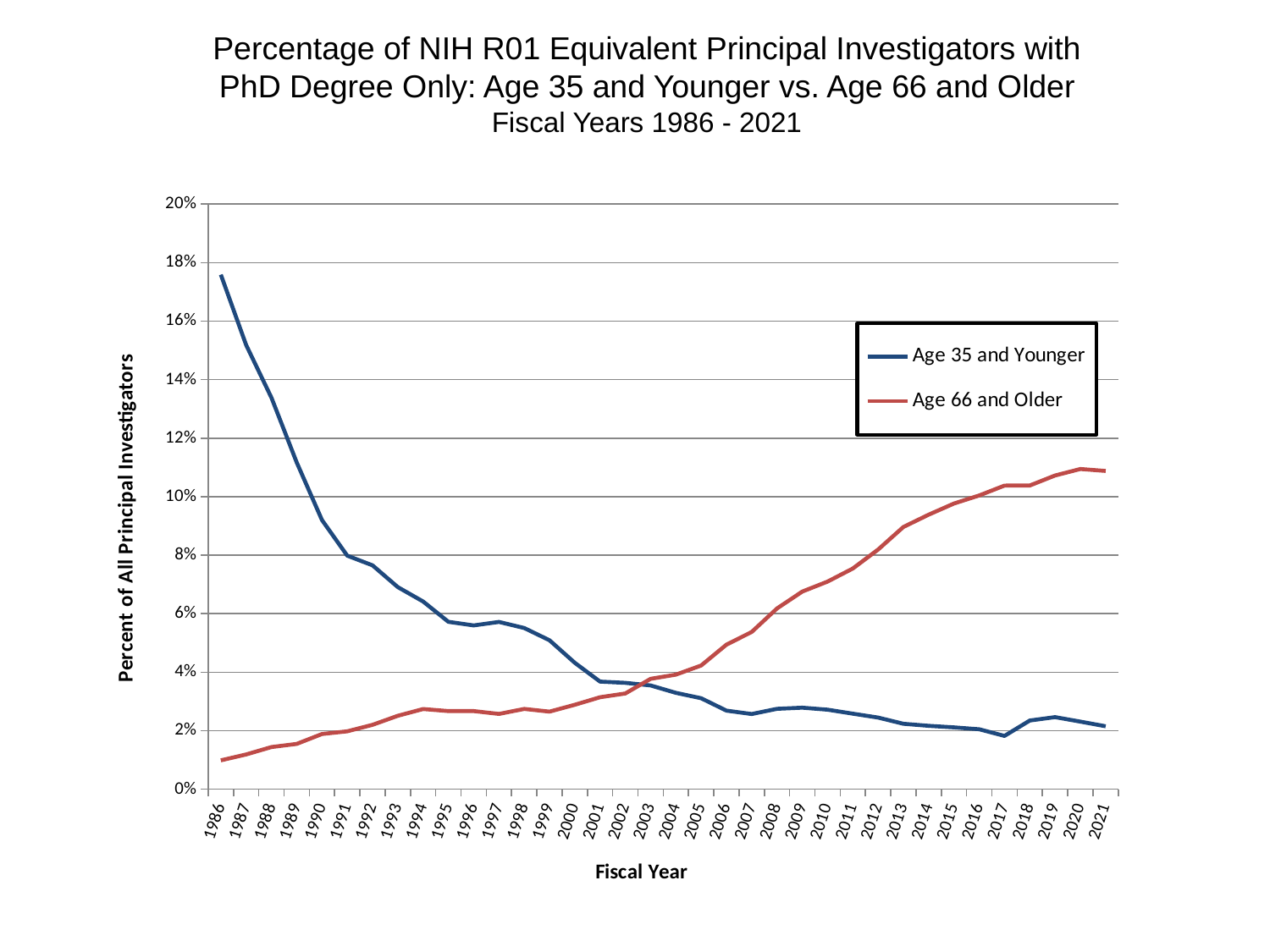
Is the value for Age 35 and Younger in 2021 greater or less than 4%? less In 2015, which series has the higher value, Age 35 and Younger or Age 66 and Older? Age 66 and Older Does the Age 35 and Younger line rise or fall from 1986 to 2021? Fall Does the Age 66 and Older line rise or fall from 1986 to 2021? Rise How many series does the legend list? 2 Is the value for Age 66 and Older in 1986 greater or less than 2%? less What kind of chart is shown on the slide? Line chart Is the value for Age 35 and Younger in 1986 greater or less than 16%? greater In 1990, which series has the higher value, Age 35 and Younger or Age 66 and Older? Age 35 and Younger How many fiscal years are plotted along the x axis? 36 In which fiscal year is the Age 35 and Younger series at its highest? 1986